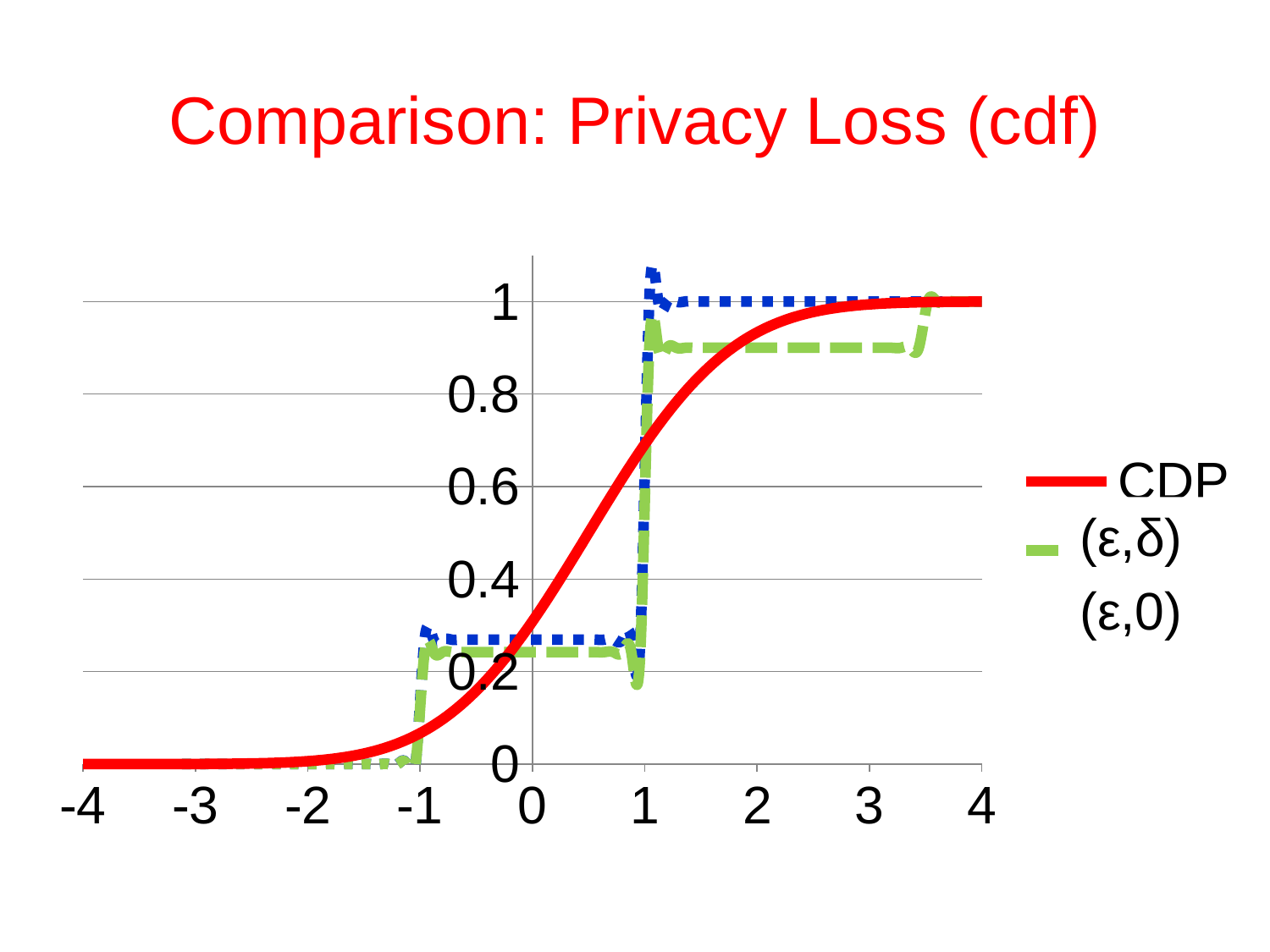
At x = 3, which line is higher, CDP or (ε,δ)? CDP What is the title of the chart? Comparison: Privacy Loss (cdf) Which series is drawn as a solid red line? CDP Is the value of the CDP line at x = -2 greater or less than 0.2? less Does the CDP line rise or fall as x increases from -4 to 4? rise What kind of chart is shown on the slide? line chart How many series does the legend list? 3 Is the value of the (ε,δ) line at x = 2 greater or less than 0.8? greater At x = 0.5, which line is higher, CDP or (ε,0)? CDP Is the value of the (ε,0) line at x = 0 greater or less than 0.4? less